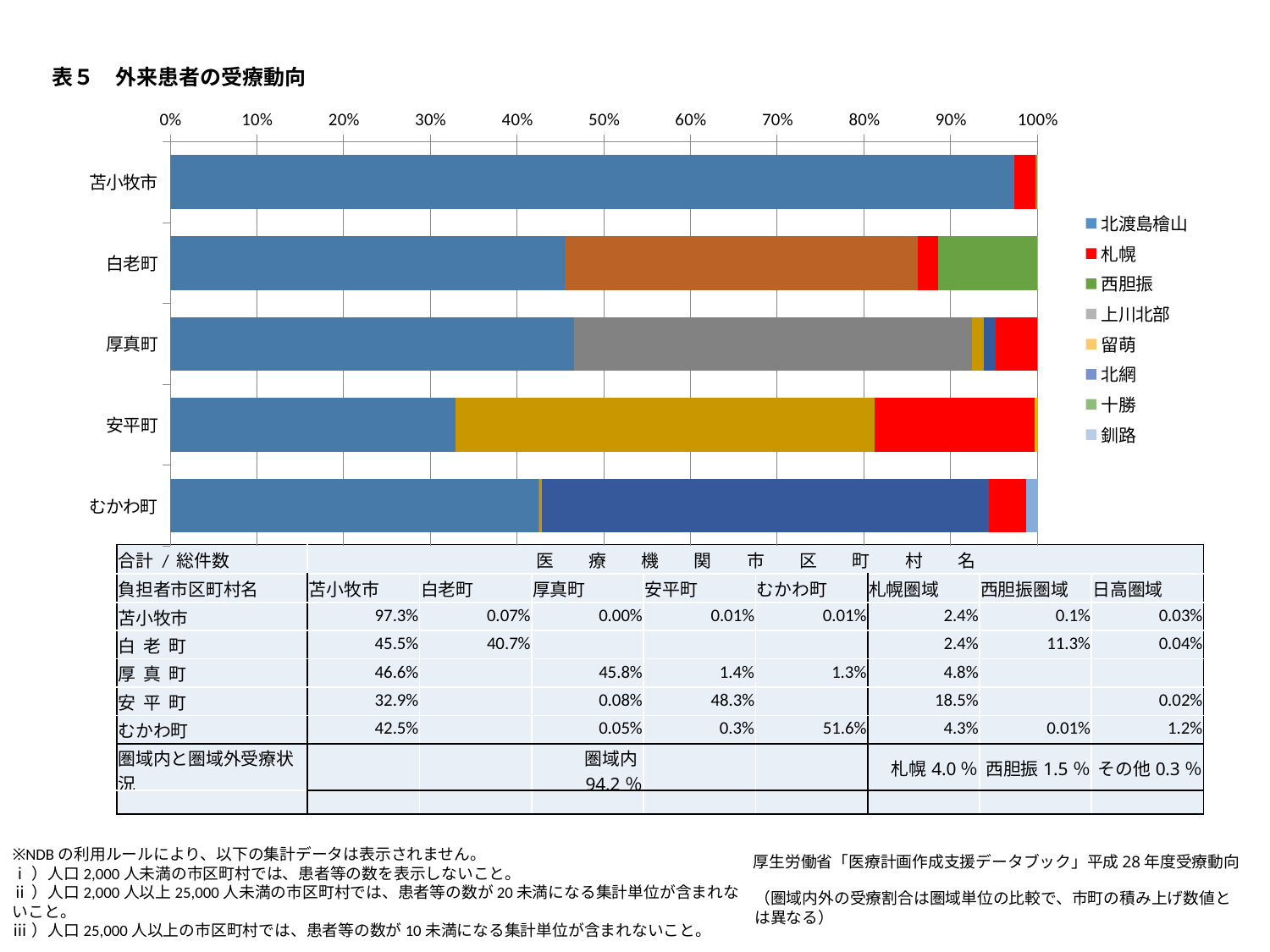
Which legend entry is shown in red? 札幌 Is the first (blue) segment for むかわ町 greater or less than 40%? greater How many categories (municipalities) are plotted on the vertical axis of the chart? 5 How many series does the chart legend list? 8 Which category has the smallest first (blue, 北渡島檜山) segment in the chart? 安平町 Which has the larger first (blue) segment, 白老町 or 安平町? 白老町 What kind of chart is shown on the slide? Stacked bar chart What is the title shown above the chart? 表５ 外来患者の受療動向 Is the first (blue) segment for 安平町 greater or less than 40%? less Which category has the largest first (blue, 北渡島檜山) segment in the chart? 苫小牧市 Is the first (blue) segment for 苫小牧市 greater or less than 90%? greater